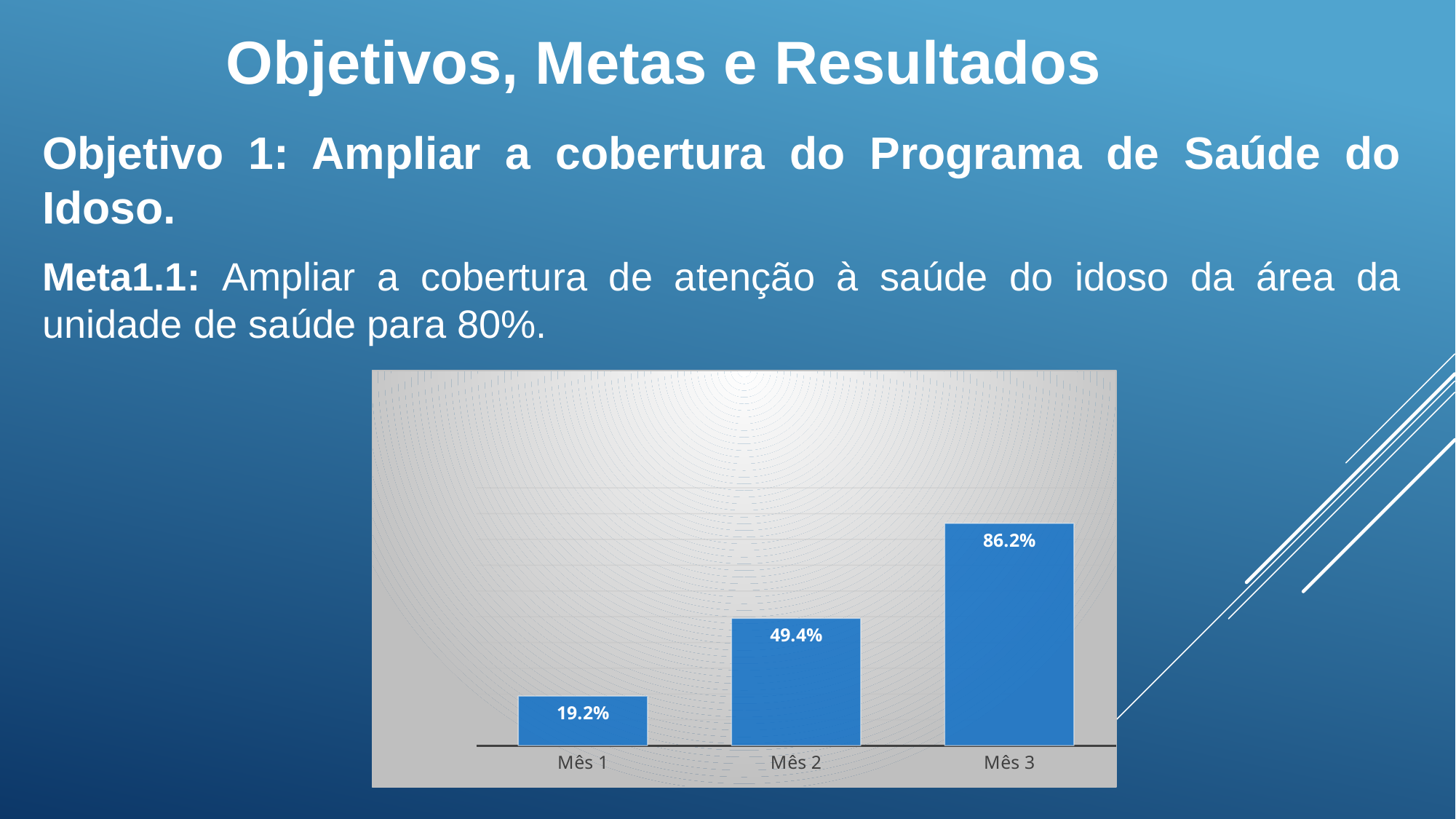
How many categories are shown on the x axis? 3 What is the difference between the values for Mês 2 and Mês 1? 30.2% Which month has the highest value? Mês 3 Do the values rise or fall from Mês 1 to Mês 3? rise Which month has the lowest value? Mês 1 What is the value for Mês 2? 49.4% What is the value for Mês 1? 19.2% What is the difference between the values for Mês 3 and Mês 2? 36.8% What colour are the bars in the chart? blue What kind of chart is shown on the slide? bar chart What is the value for Mês 3? 86.2% Which is larger, the value for Mês 1 or the value for Mês 2? Mês 2